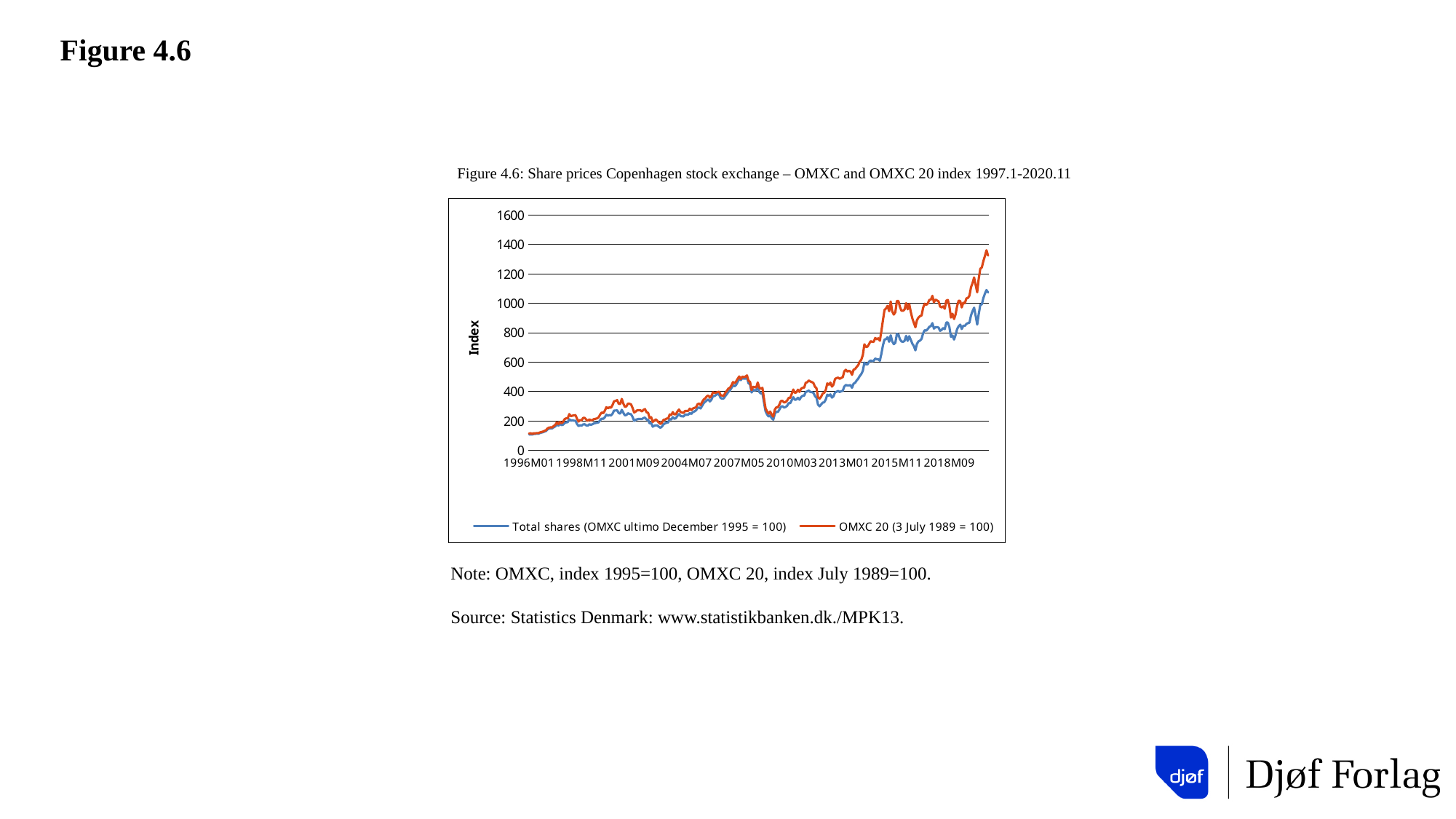
How many date labels are shown on the x axis? 9 What is the title of the chart? Figure 4.6: Share prices Copenhagen stock exchange – OMXC and OMXC 20 index 1997.1-2020.11 At 1996M01, is the value of the Total shares (OMXC ultimo December 1995 = 100) series greater or less than 200? less What is the label on the vertical axis? Index At the end of the period, is the value of the Total shares (OMXC ultimo December 1995 = 100) series greater or less than 1000? greater What is the highest value shown on the y axis? 1600 What kind of chart is shown on the slide? line chart Overall, do the index values rise or fall from 1996M01 to the end of the period? rise At the end of the period, is the value of the OMXC 20 (3 July 1989 = 100) series greater or less than 1200? greater How many series does the legend list? 2 At the end of the period, which series has the higher value: Total shares (OMXC ultimo December 1995 = 100) or OMXC 20 (3 July 1989 = 100)? OMXC 20 (3 July 1989 = 100)